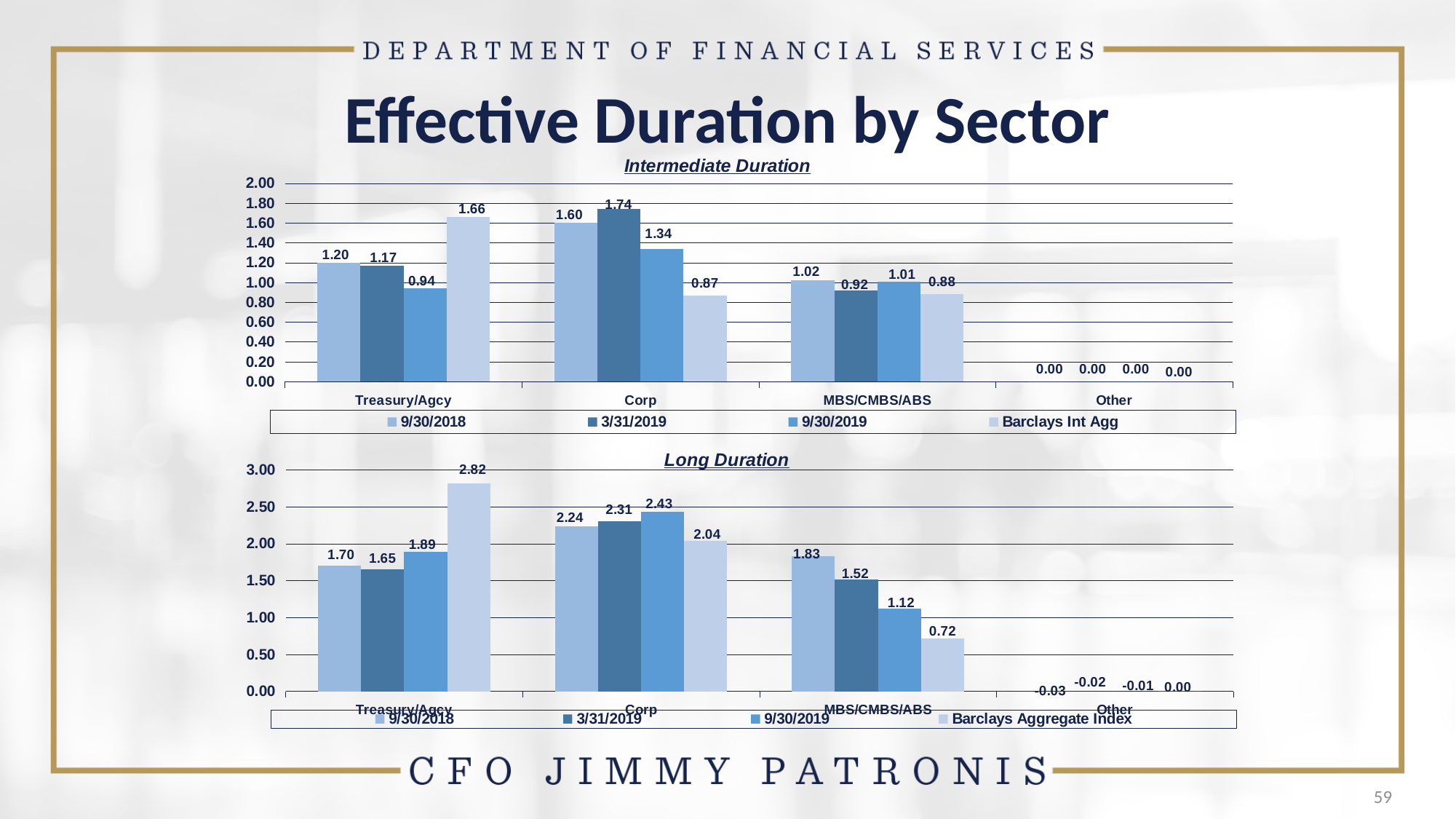
In the Intermediate Duration chart, what is the Barclays Int Agg value for Treasury/Agcy? 1.66 In the Intermediate Duration chart, which sector has the highest 9/30/2018 value? Corp How many sector categories are shown on the x axis of the Intermediate Duration chart? 4 In the Long Duration chart, what is the difference between the 9/30/2018 and 9/30/2019 values for MBS/CMBS/ABS? 0.71 In the Intermediate Duration chart, what is the value for Corp in the 3/31/2019 series? 1.74 In the Long Duration chart, which sector has the lowest Barclays Aggregate Index value? Other What kind of chart is the Intermediate Duration chart? Bar chart In the Long Duration chart, is the Barclays Aggregate Index value for Treasury/Agcy greater or less than 2.50? greater In the Long Duration chart, what is the value for MBS/CMBS/ABS in the 9/30/2019 series? 1.12 In the Long Duration chart, what is the Barclays Aggregate Index value for Corp? 2.04 In the Intermediate Duration chart, which is larger for Treasury/Agcy: the 9/30/2018 value or the 9/30/2019 value? 9/30/2018 How many series does the legend of the Long Duration chart list? 4